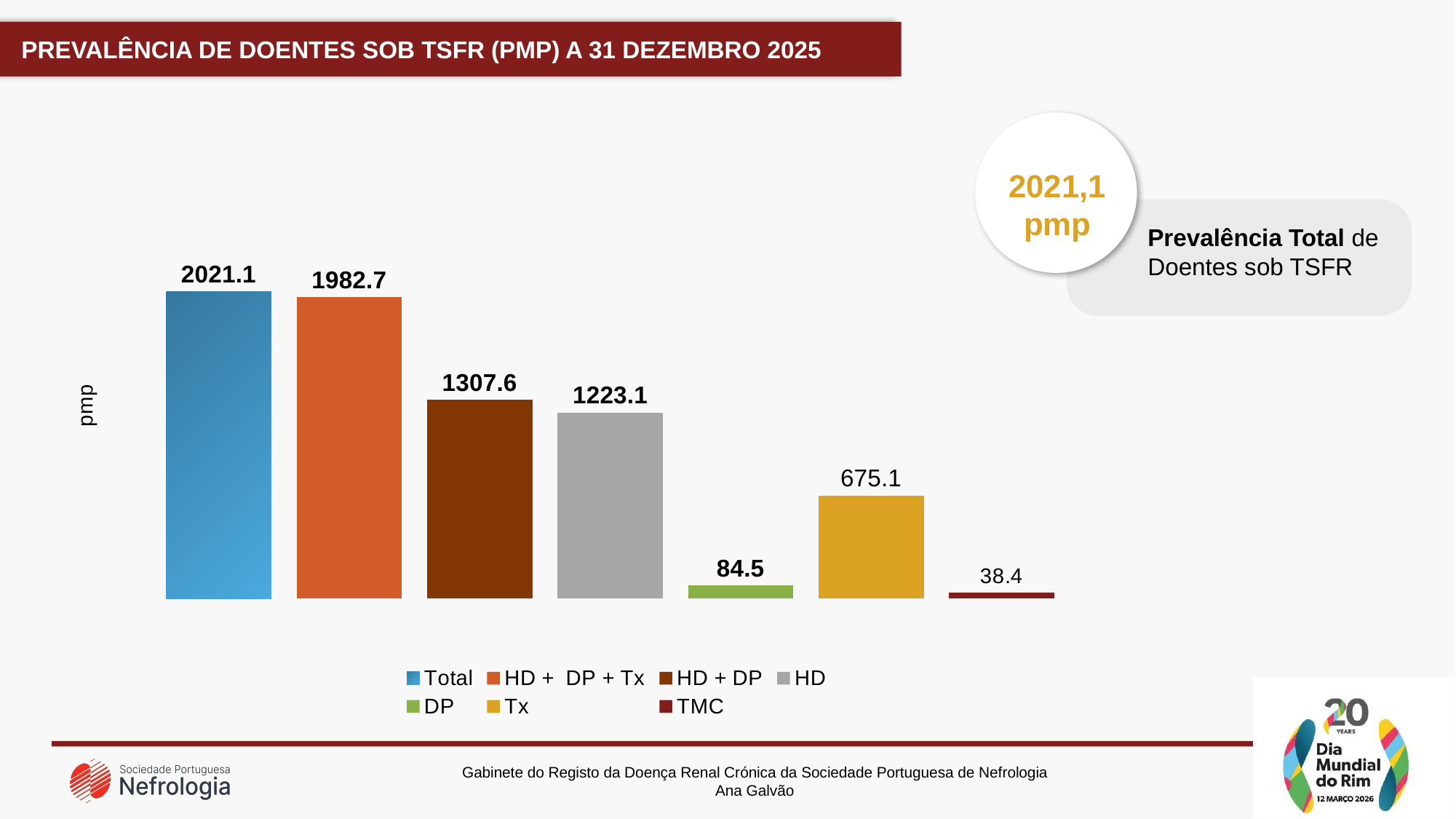
What is the value for Tx? 675.1 What is the value for TMC? 38.4 What is the value for Total? 2021.1 What is the difference between the values for HD + DP and HD? 84.5 How many entries does the legend list? 7 Which category has the highest value? Total Which is larger, the value for DP or the value for Tx? Tx What kind of chart is shown on the slide? Bar chart Which category has the lowest value? TMC How many bars are plotted in the chart? 7 What is the value for HD? 1223.1 What is the value for HD + DP + Tx? 1982.7